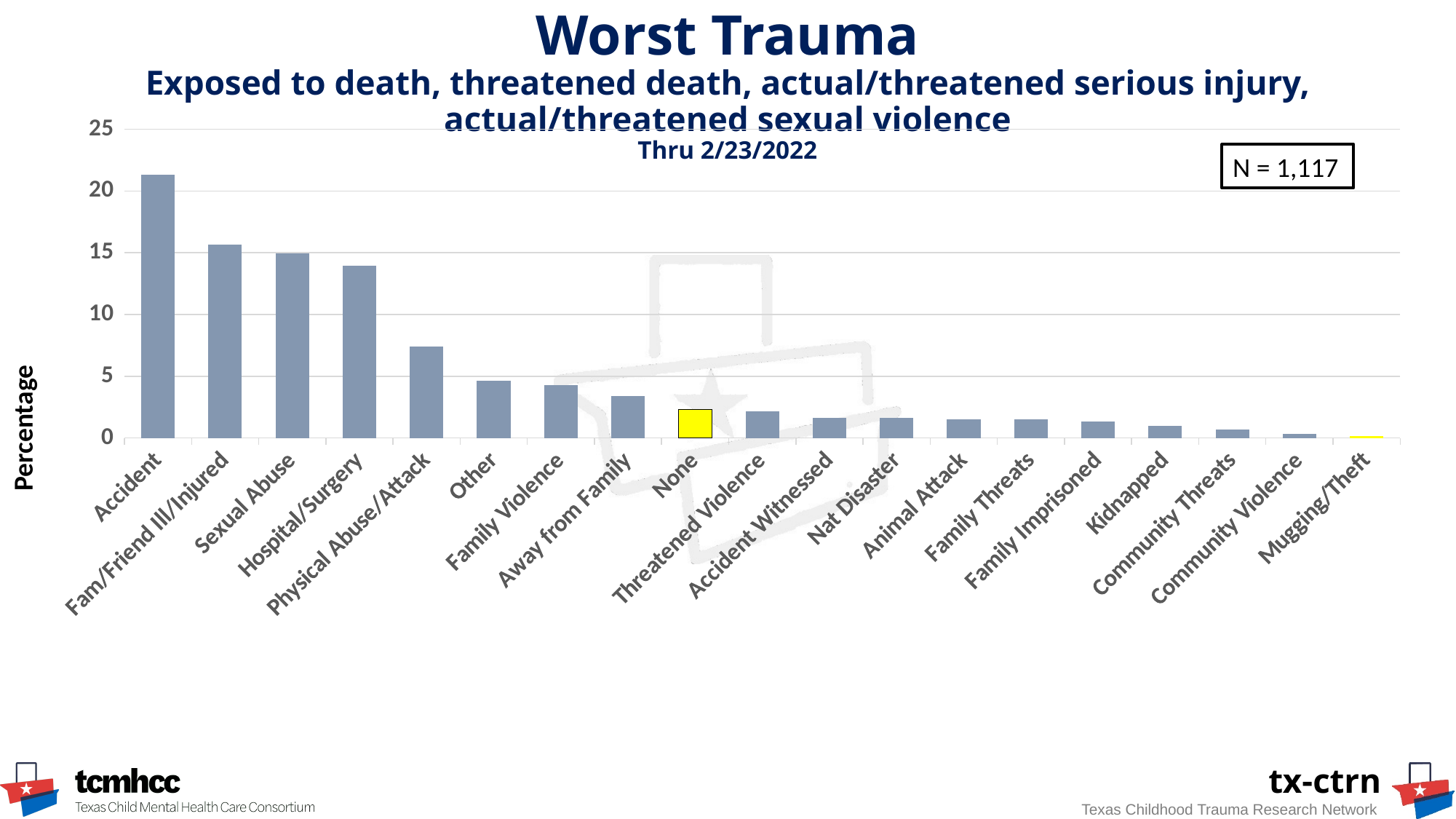
Which category has the highest value in the chart? Accident How many categories are shown on the x axis of the chart? 19 Do the values rise or fall moving from left to right along the x axis? fall Which category has the lowest value in the chart? Mugging/Theft Is the value for Accident greater or less than 20? greater What kind of chart is shown on the slide? bar chart What is the label on the y axis of the chart? Percentage What sample size (N) is shown in the box on the slide? N = 1,117 Is the value for Physical Abuse/Attack greater or less than 5? greater Is the value for Nat Disaster greater or less than 5? less Which is larger, the value for Sexual Abuse or the value for Other? Sexual Abuse